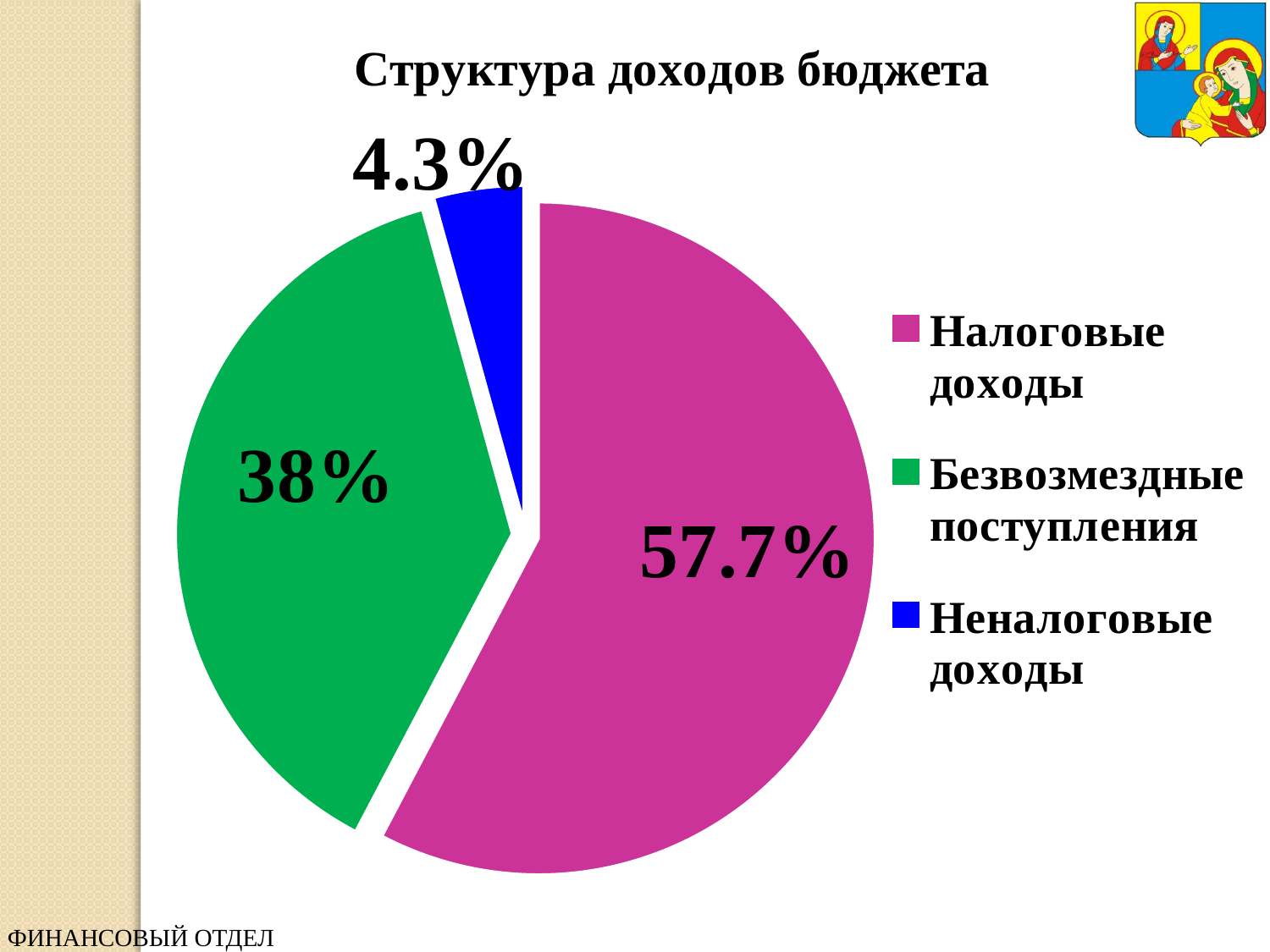
What colour is the slice for Неналоговые доходы? Blue What is the difference between the shares of Налоговые доходы and Безвозмездные поступления? 19.7% Which category has the largest share of the pie? Налоговые доходы What share of the pie is Неналоговые доходы? 4.3% What share of the pie is Безвозмездные поступления? 38% What is the difference between the shares of Безвозмездные поступления and Неналоговые доходы? 33.7% How many categories does the pie chart have? 3 What type of chart is shown on the slide? Pie chart What share of the pie is Налоговые доходы? 57.7% What is the title of the chart? Структура доходов бюджета Which category has the smallest share of the pie? Неналоговые доходы Which is larger: the share of Безвозмездные поступления or the share of Неналоговые доходы? Безвозмездные поступления